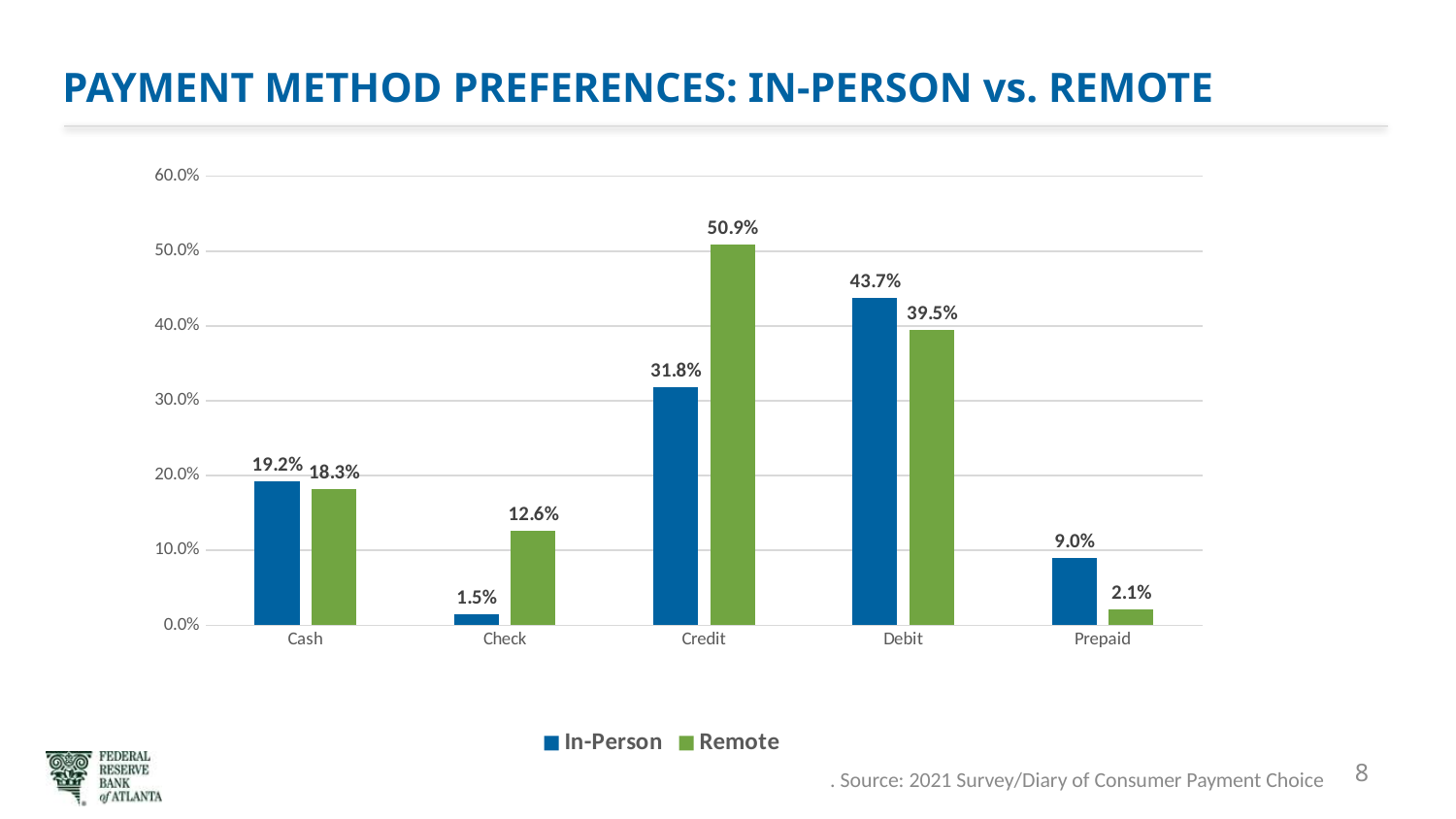
What is the difference between the Remote and In-Person values for Credit? 19.1% What colour represents the Remote series? Green What is the In-Person value for Credit? 31.8% What kind of chart is shown on the slide? Bar chart How many payment method categories are shown on the x axis? 5 Which payment method has the lowest Remote value? Prepaid Is the Remote value for Credit greater or less than 50.0%? greater What is the Remote value for Check? 12.6% Which payment method has the highest In-Person value? Debit How many series does the legend list? 2 Which is larger for Debit, the In-Person value or the Remote value? In-Person What is the Remote value for Prepaid? 2.1%